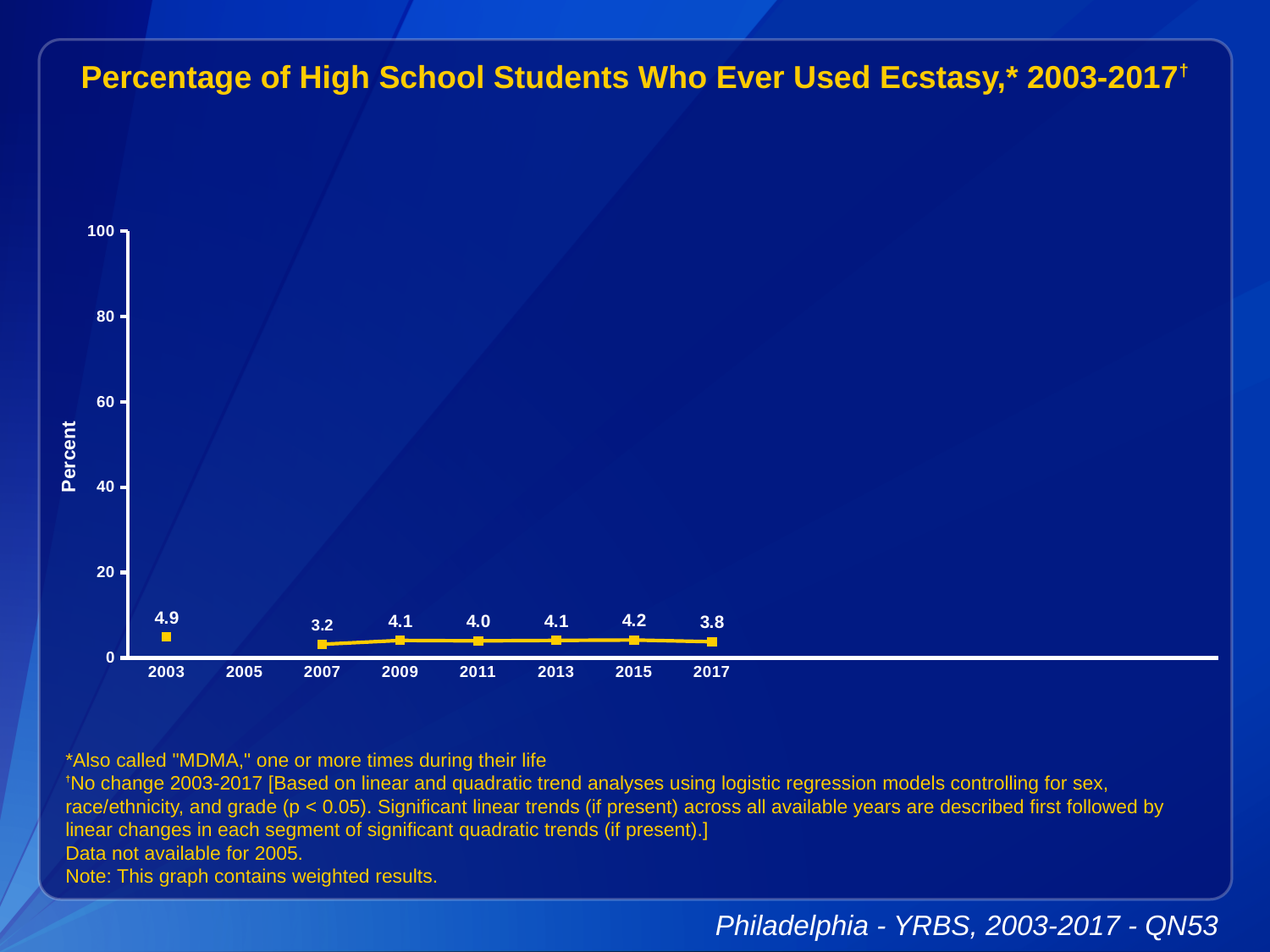
Which year has the lowest percentage of students who ever used ecstasy? 2007 Is the value for 2013 greater or less than 20? less How many years have a data point plotted on the chart? 7 What is the difference between the 2003 value and the 2007 value? 1.7 What percentage of high school students had ever used ecstasy in 2003? 4.9 What kind of chart is shown on the slide? line chart What is the difference between the 2015 value and the 2017 value? 0.4 Which year has the highest percentage of students who ever used ecstasy? 2003 What is the value plotted for 2015? 4.2 Which year has a larger value, 2009 or 2017? 2009 What is the value plotted for 2017? 3.8 What is the value plotted for 2007? 3.2